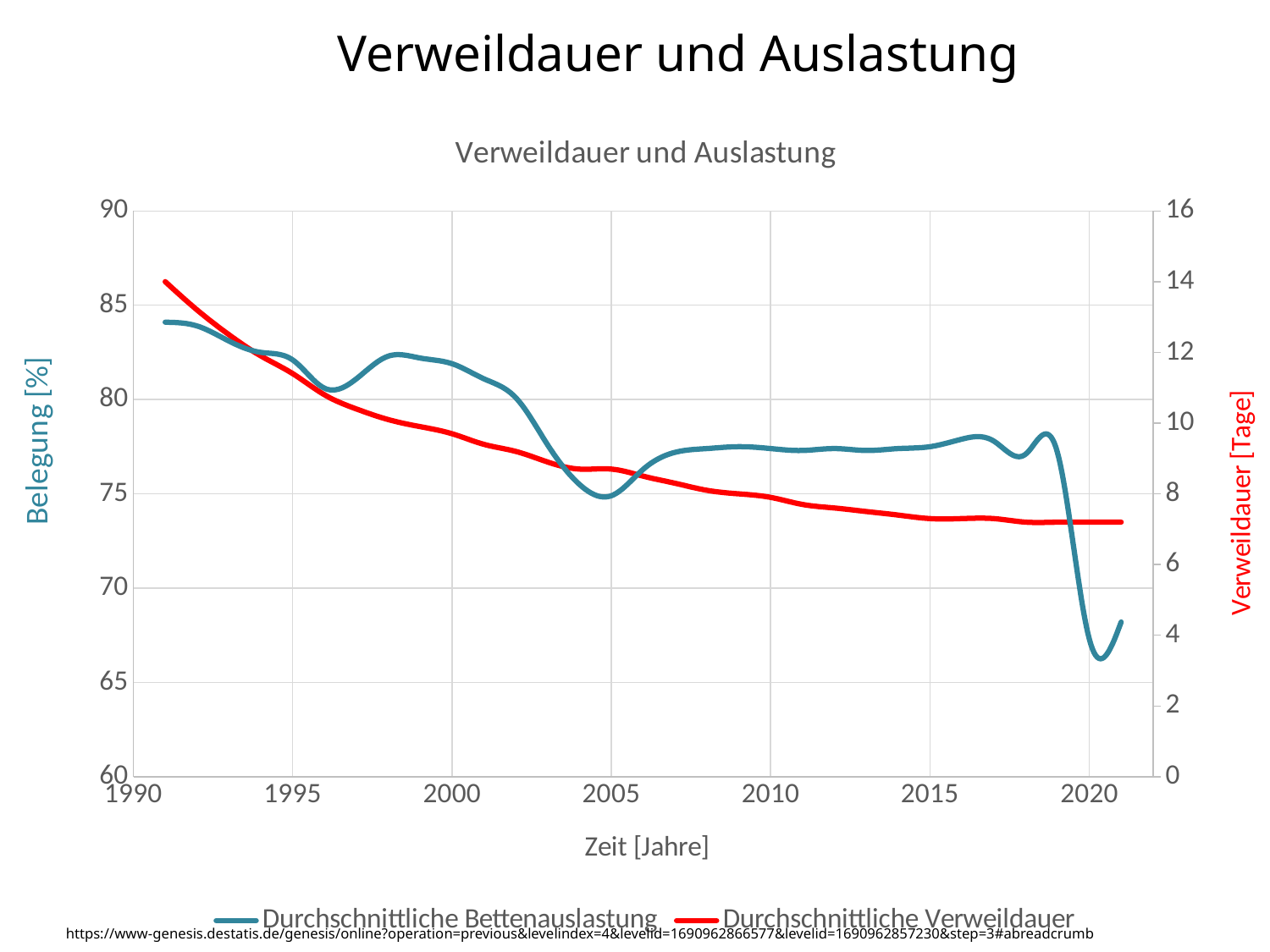
Is the Durchschnittliche Bettenauslastung value around 2020 greater or less than 70%? less What is the title of the chart? Verweildauer und Auslastung What kind of chart is shown on the slide? line chart Is the Durchschnittliche Bettenauslastung value around 2010 greater or less than 75%? greater How many series does the legend list? 2 Is the Durchschnittliche Verweildauer value at the start of the series (around 1991) greater or less than 12 days? greater Around which year does the Durchschnittliche Bettenauslastung line reach its lowest value? 2020 Around which year does the Durchschnittliche Verweildauer line reach its highest value? 1991 What is the label of the x axis? Zeit [Jahre] Does the Durchschnittliche Bettenauslastung line rise or fall overall from 1990 to 2020? fall Does the Durchschnittliche Verweildauer line rise or fall overall from 1990 to 2020? fall